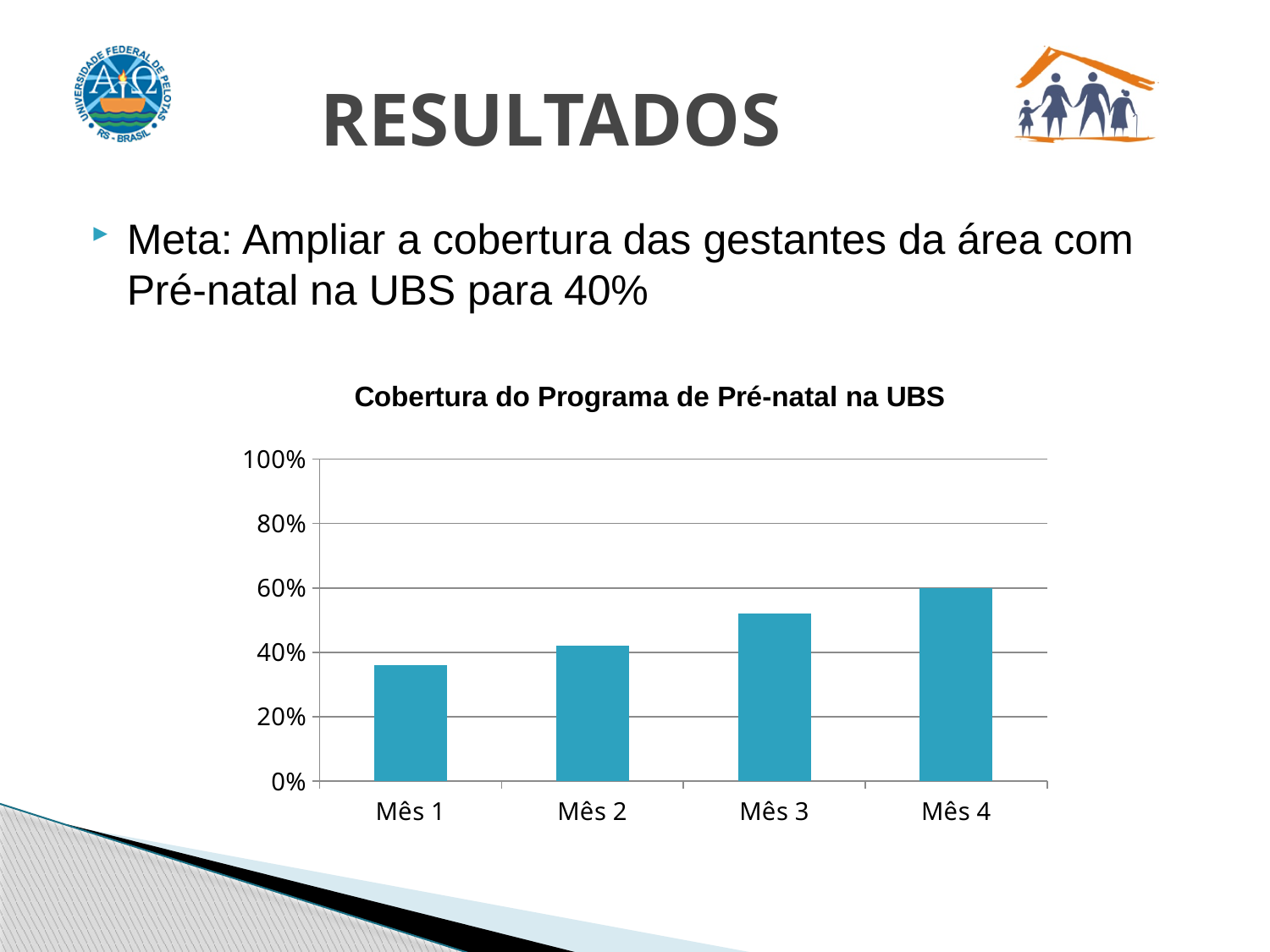
Which month has the highest coverage in the chart? Mês 4 What kind of chart is shown on the slide? bar chart What is the title of the chart? Cobertura do Programa de Pré-natal na UBS How many categories (months) are shown on the x axis of the chart? 4 Is the value for Mês 1 greater or less than 40%? less Is the value for Mês 3 greater or less than 60%? less What is the highest value shown on the y axis of the chart? 100% Do the values rise or fall from Mês 1 to Mês 4? rise Is the value for Mês 1 greater or less than 20%? greater Which is larger, the value for Mês 3 or the value for Mês 2? Mês 3 Which month has the lowest coverage in the chart? Mês 1